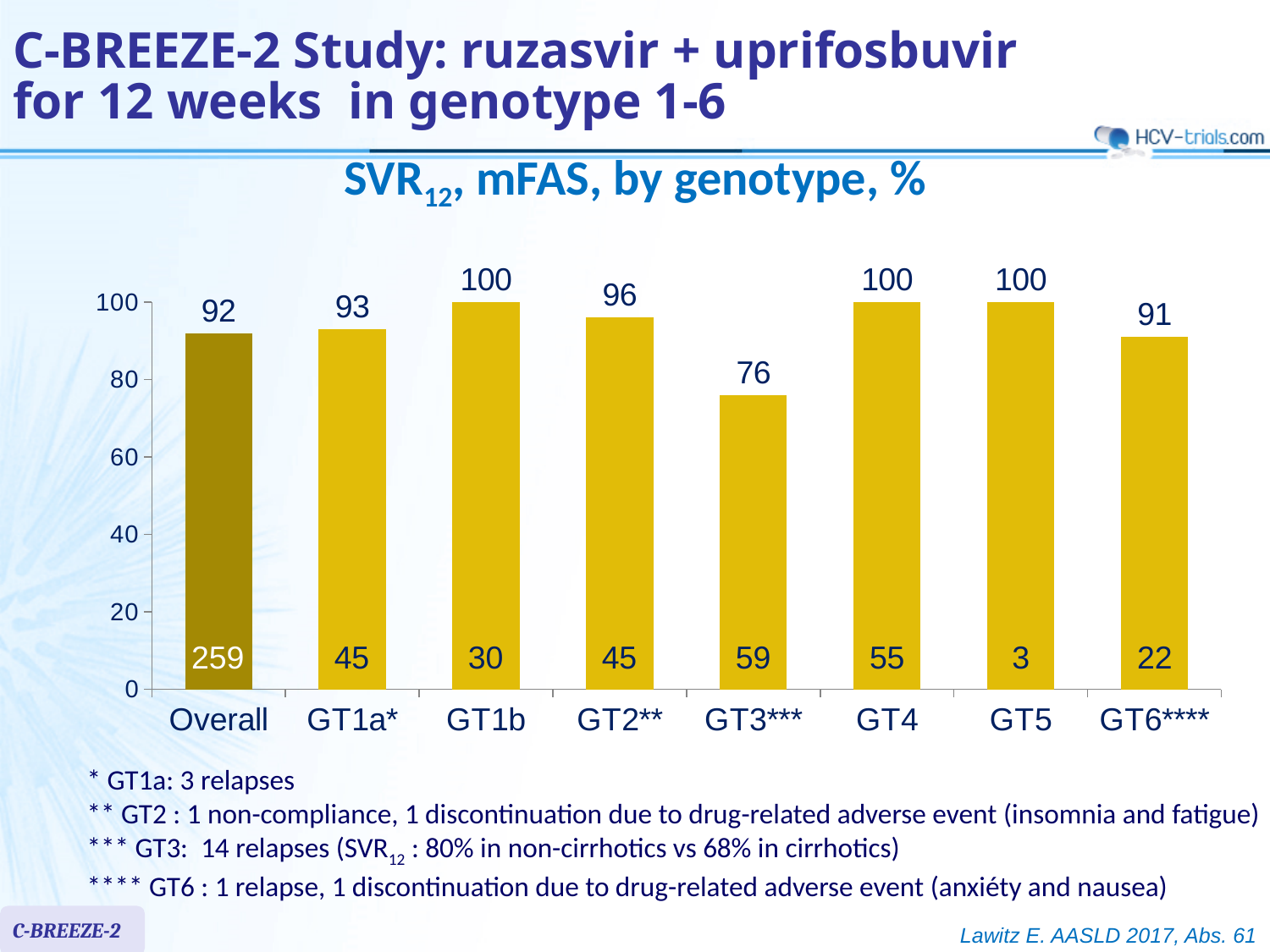
How many patients are in the Overall group, as shown inside the bar? 259 Is the SVR12 value for GT3*** greater or less than 80? less How many patients are in the GT5 group, as shown inside the bar? 3 What is the SVR12 value for the Overall group? 92 What is the title of the chart? SVR12, mFAS, by genotype, % What is the difference between the SVR12 values for GT1b and GT3***? 24 Which has a higher SVR12 value, GT2** or GT6****? GT2** How many categories are shown on the x axis? 8 What is the SVR12 value for GT3***? 76 Which genotype has the lowest SVR12 value? GT3*** What kind of chart is shown on the slide? bar chart What is the SVR12 value for GT6****? 91